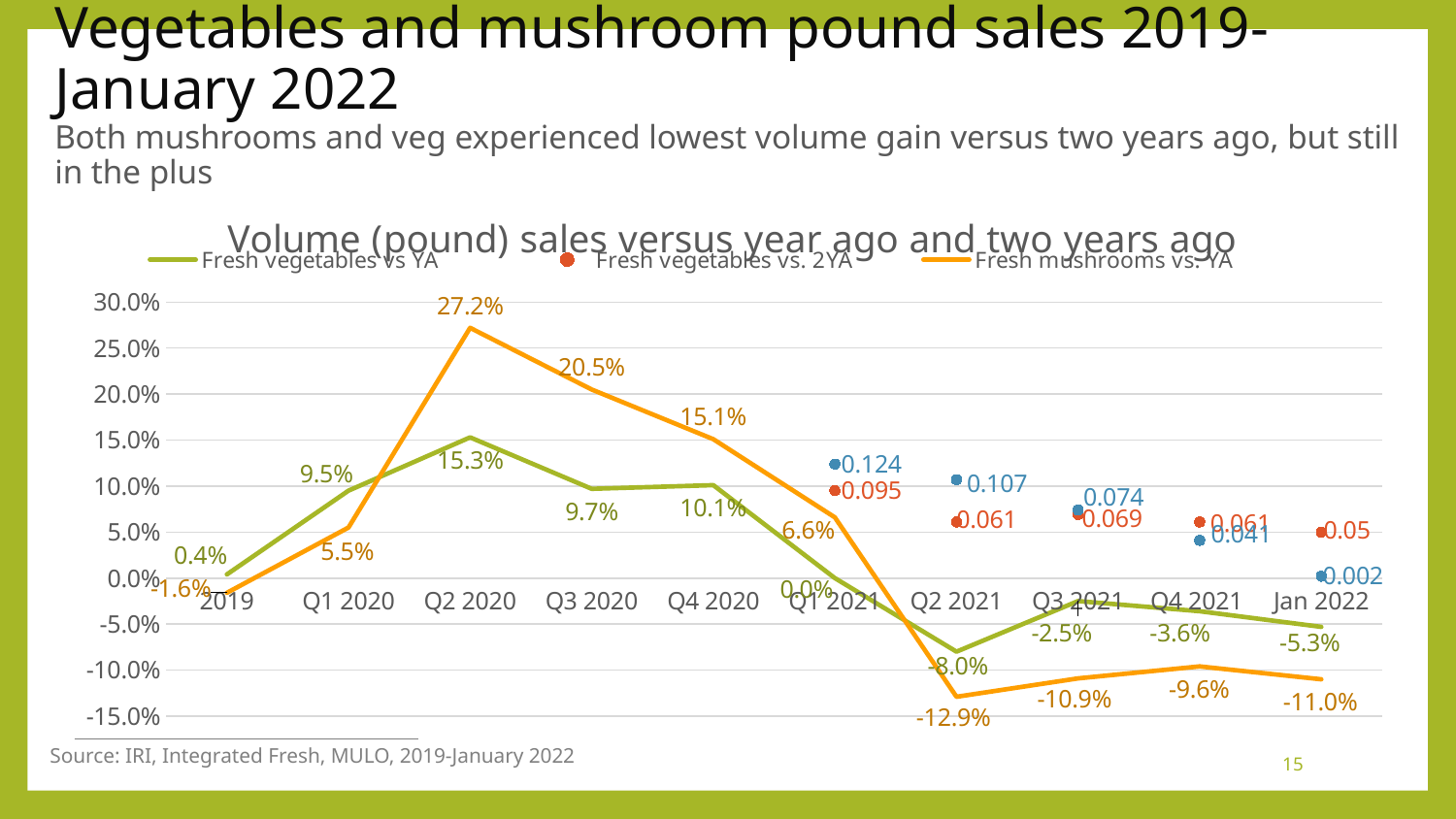
What is the value for Fresh mushrooms vs. YA in Q2 2020? 27.2% What is the value for Fresh vegetables vs YA in Q4 2020? 10.1% How many time periods are shown on the x axis? 10 Does Fresh mushrooms vs. YA rise or fall from Q2 2020 to Q4 2020? Fall What is the value for Fresh vegetables vs. 2YA in Jan 2022? 0.05 In Q1 2020, which is larger: Fresh vegetables vs YA or Fresh mushrooms vs. YA? Fresh vegetables vs YA How many series does the legend list? 3 In which period is Fresh mushrooms vs. YA lowest? Q2 2021 In which period is Fresh vegetables vs YA lowest? Q2 2021 In Q2 2020, how much higher is Fresh mushrooms vs. YA than Fresh vegetables vs YA? 11.9 percentage points What kind of chart is shown on the slide? Line chart In which period is Fresh mushrooms vs. YA highest? Q2 2020